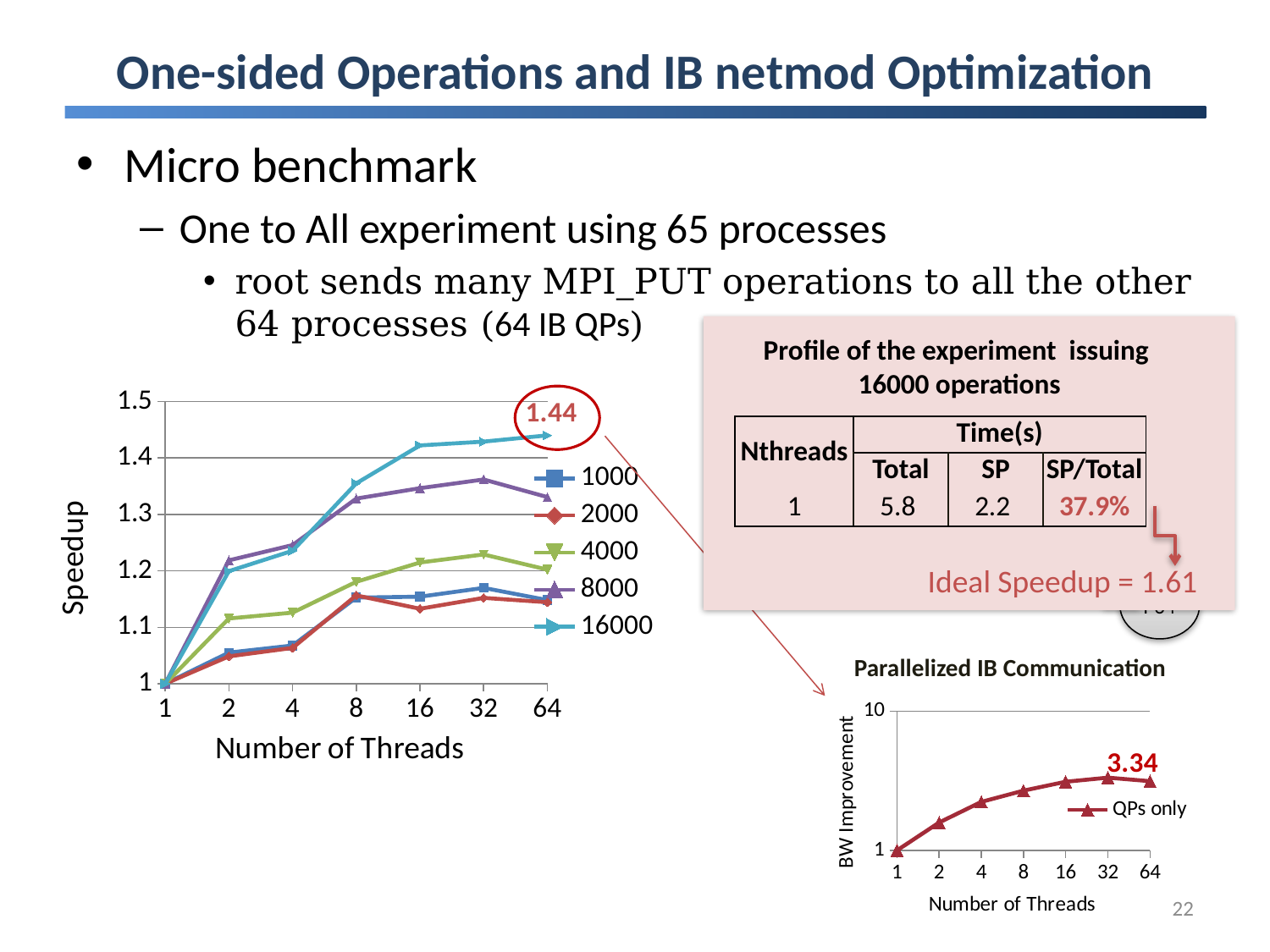
In the left Speedup chart, what is the speedup of the 16000 series at 64 threads? 1.44 In the Parallelized IB Communication chart, what is the legend entry for the plotted series? QPs only In the left Speedup chart, how many series does the legend list? 5 In the left Speedup chart, does the 16000 series generally rise or fall as the number of threads increases? rise In the left Speedup chart, is the speedup of the 8000 series at 64 threads greater or less than 1.3? greater In the left Speedup chart, which series has the highest speedup at 64 threads? 16000 In the Parallelized IB Communication chart, how many series does the legend list? 1 In the left Speedup chart, how many thread counts are plotted on the x axis? 7 In the left Speedup chart, at 32 threads, which series has the larger speedup, 8000 or 4000? 8000 In the left Speedup chart, is the speedup of the 1000 series at 2 threads greater or less than 1.1? less What type of chart is the left chart showing Speedup versus Number of Threads? line chart